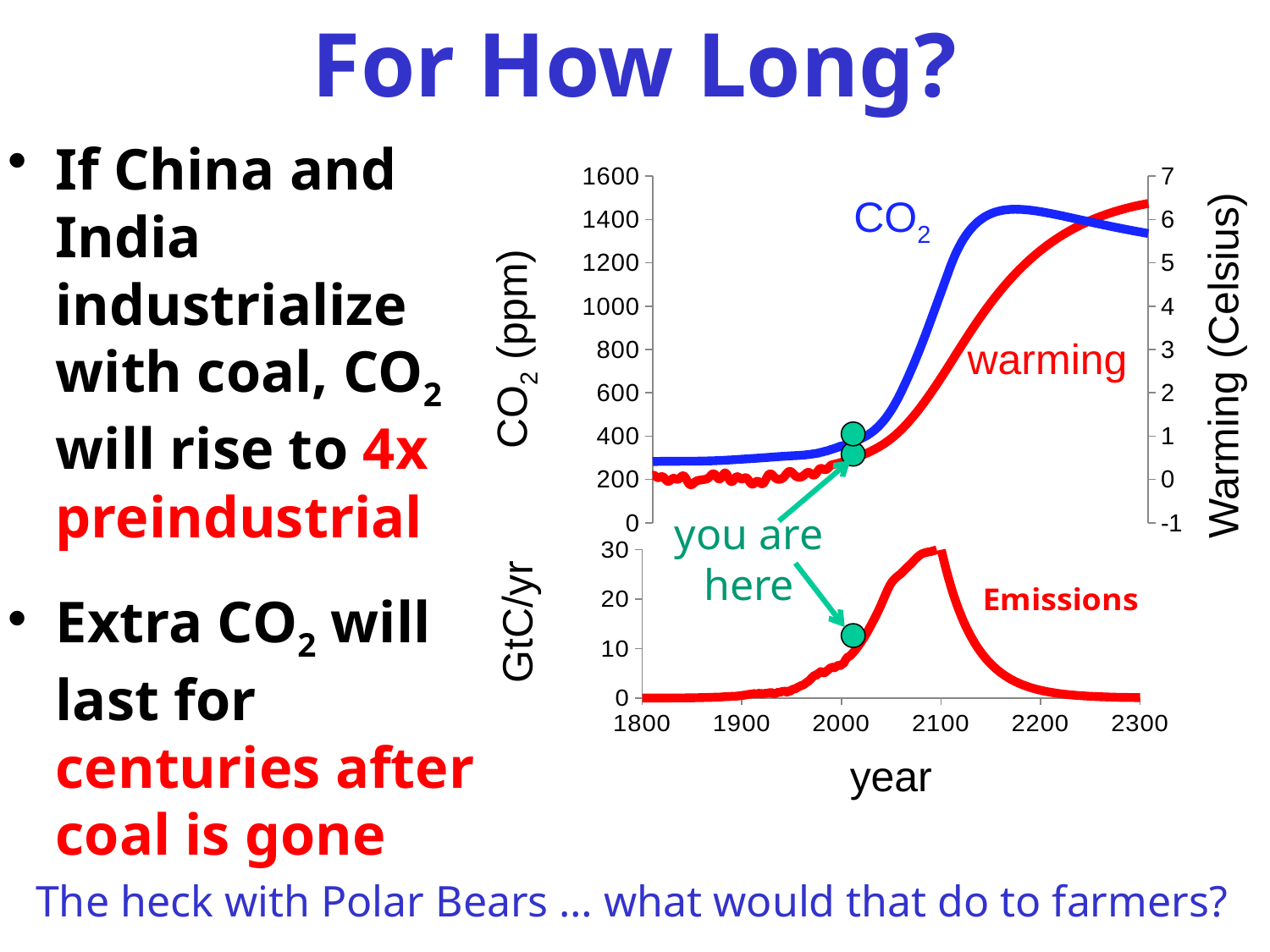
What kind of chart is the lower chart showing Emissions? line chart In the lower chart, is the Emissions value in 2300 greater or less than 10 GtC/yr? less In the upper chart, is the CO2 value in 1800 greater or less than 400 ppm? less In the upper chart, does the warming line rise or fall between 2000 and 2200? rise In the upper chart, is the CO2 value in 2300 greater or less than 1200 ppm? greater In the lower chart, do Emissions rise or fall between 2100 and 2300? fall What kind of chart is the upper chart showing CO2 and warming? line chart In the upper chart, what colour is the CO2 line? blue How many data series are plotted in the upper chart? 2 What is the label of the x axis shared by the two charts? year